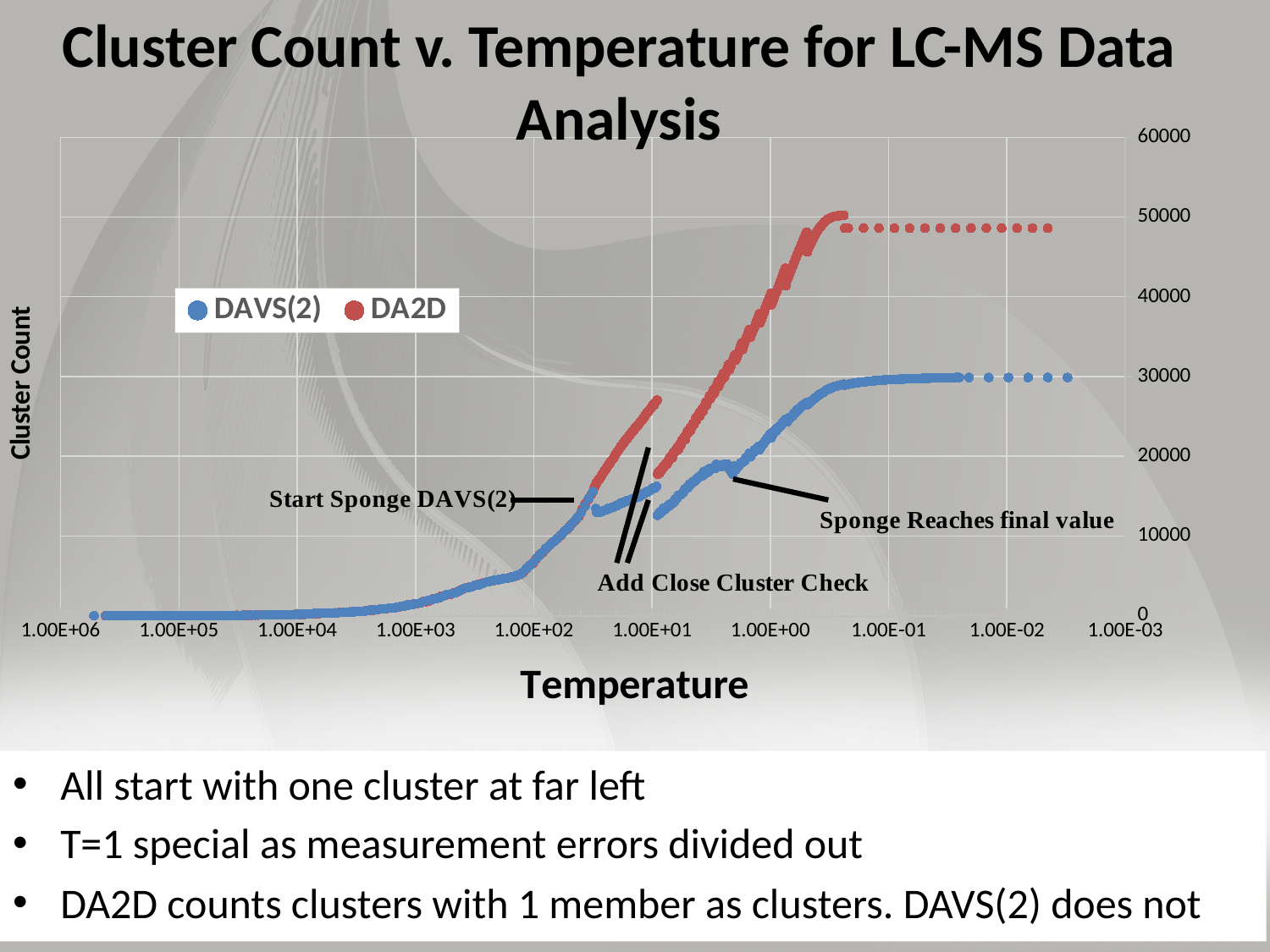
What is the title of the x axis? Temperature Which series levels off at the lower final cluster count? DAVS(2) What are the two series named in the legend? DAVS(2) and DA2D Is the value for DAVS(2) at a temperature of 1.00E+02 greater or less than 10000? less Is the final plateau value for DA2D greater or less than 40000? greater Is the final plateau value for DAVS(2) greater or less than 40000? less What kind of chart is shown on the slide? scatter chart Which series reaches the higher final cluster count at the right side of the chart? DA2D Moving from left to right along the x axis, do the cluster counts generally rise or fall? rise How many series does the legend list? 2